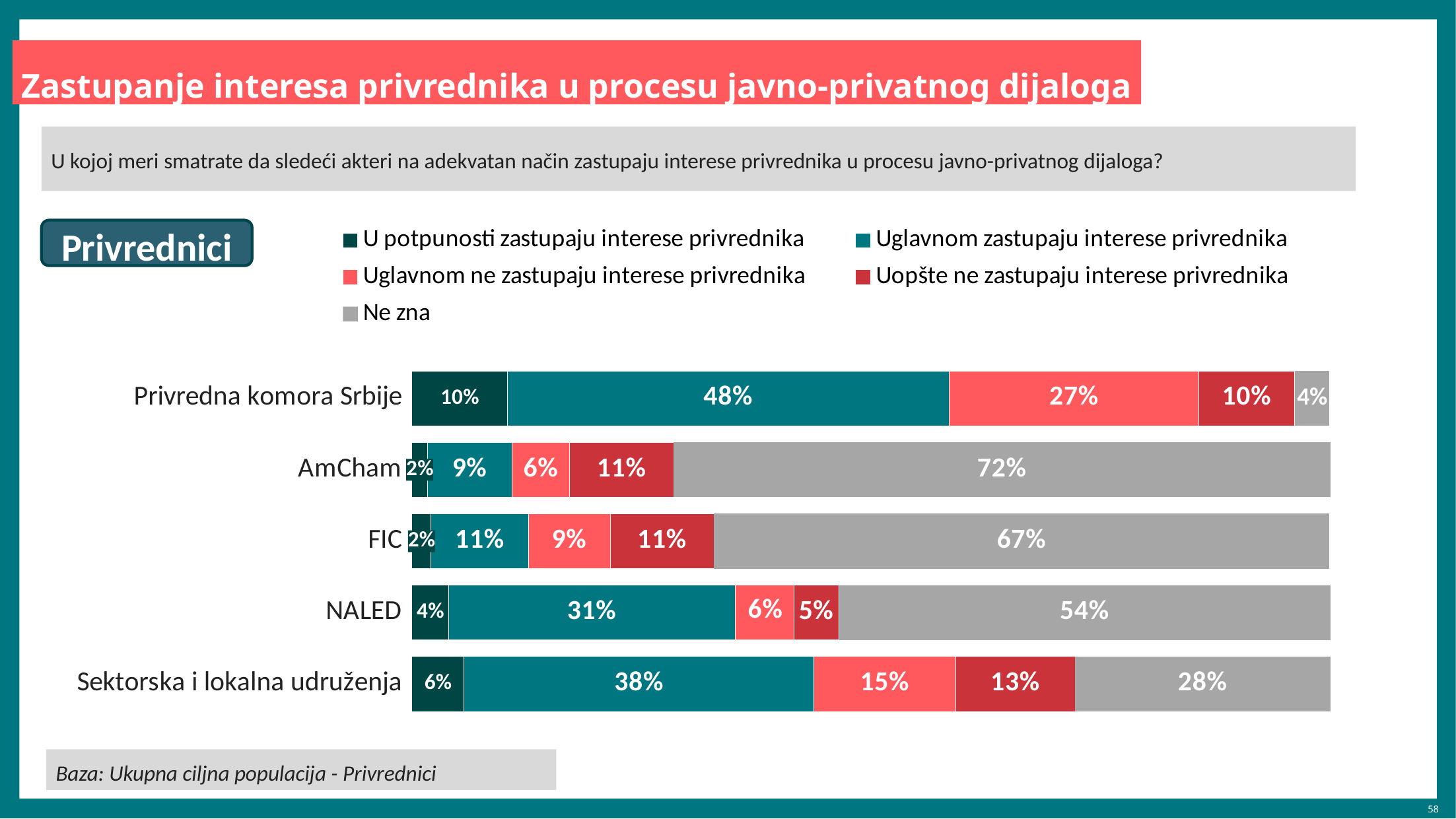
How many actors (categories) are shown in the chart? 5 What is the "Ne zna" value for AmCham? 72% Which is larger: the "Uglavnom ne zastupaju interese privrednika" value for Privredna komora Srbije or for Sektorska i lokalna udruženja? Privredna komora Srbije What is the "Uopšte ne zastupaju interese privrednika" value for Sektorska i lokalna udruženja? 13% Which actor has the lowest "Ne zna" share? Privredna komora Srbije What percentage of respondents said Privredna komora Srbije "Uglavnom zastupaju interese privrednika"? 48% What is the "Uglavnom ne zastupaju interese privrednika" value for FIC? 9% What is the total of the segments in the NALED bar? 100% What type of chart is shown on the slide? Stacked bar chart What is the difference between the "Uglavnom zastupaju interese privrednika" values for Privredna komora Srbije and NALED? 17 percentage points Which actor has the highest "Ne zna" share? AmCham How many series does the legend list? 5